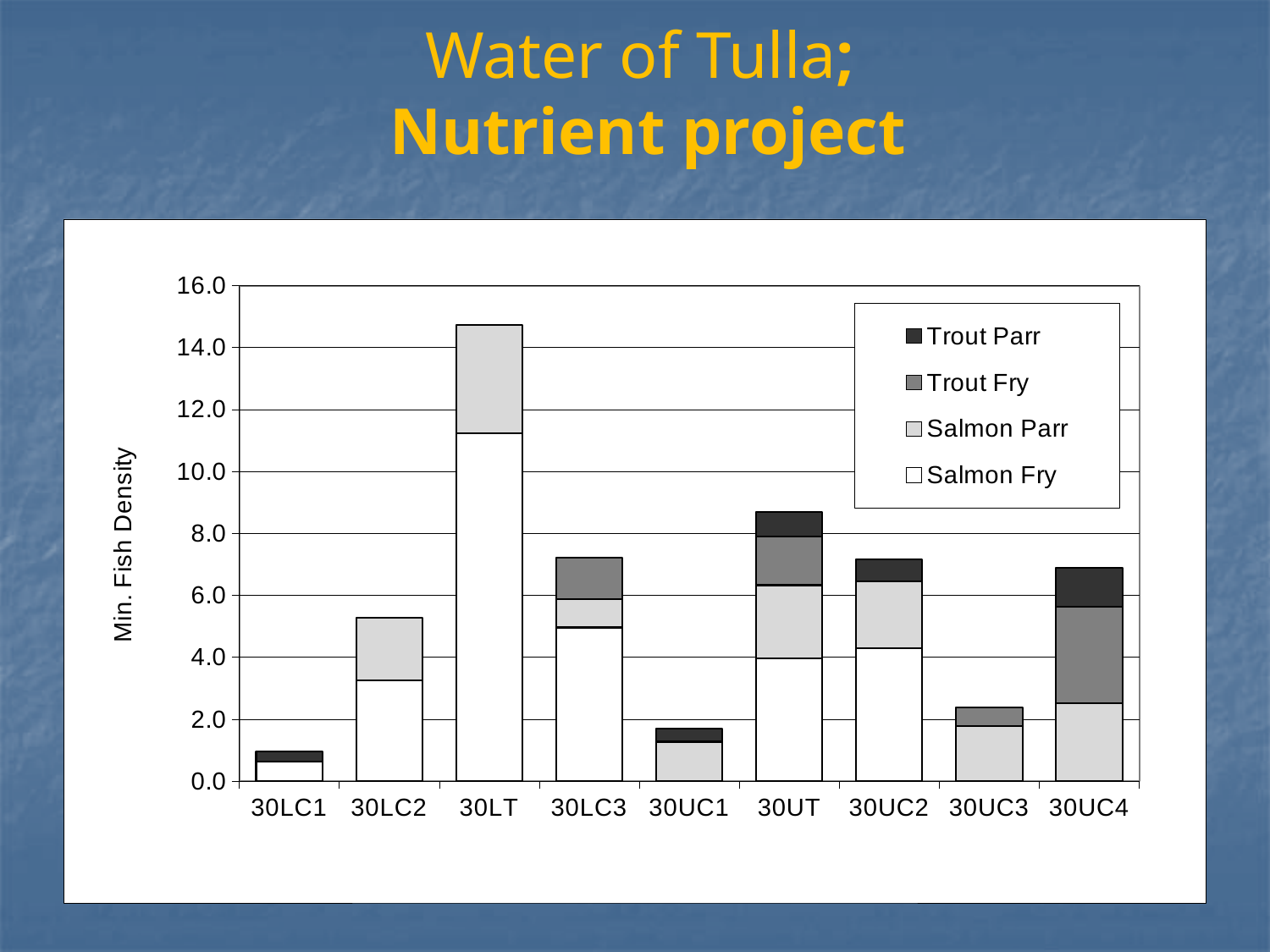
What kind of chart is shown on the slide? Stacked bar chart Which site has the lowest total minimum fish density? 30LC1 How many sites (categories) are shown along the x axis? 9 Which site has the highest total minimum fish density? 30LT Is the total value for 30UT greater or less than 8.0? greater Which has the larger total minimum fish density, 30UT or 30UC2? 30UT Is the total value for 30UC1 greater or less than 2.0? less What is the label on the y axis of the chart? Min. Fish Density Is the total value for 30LT greater or less than 14.0? greater How many series does the legend list? 4 Which has the larger total minimum fish density, 30LC2 or 30LC3? 30LC3